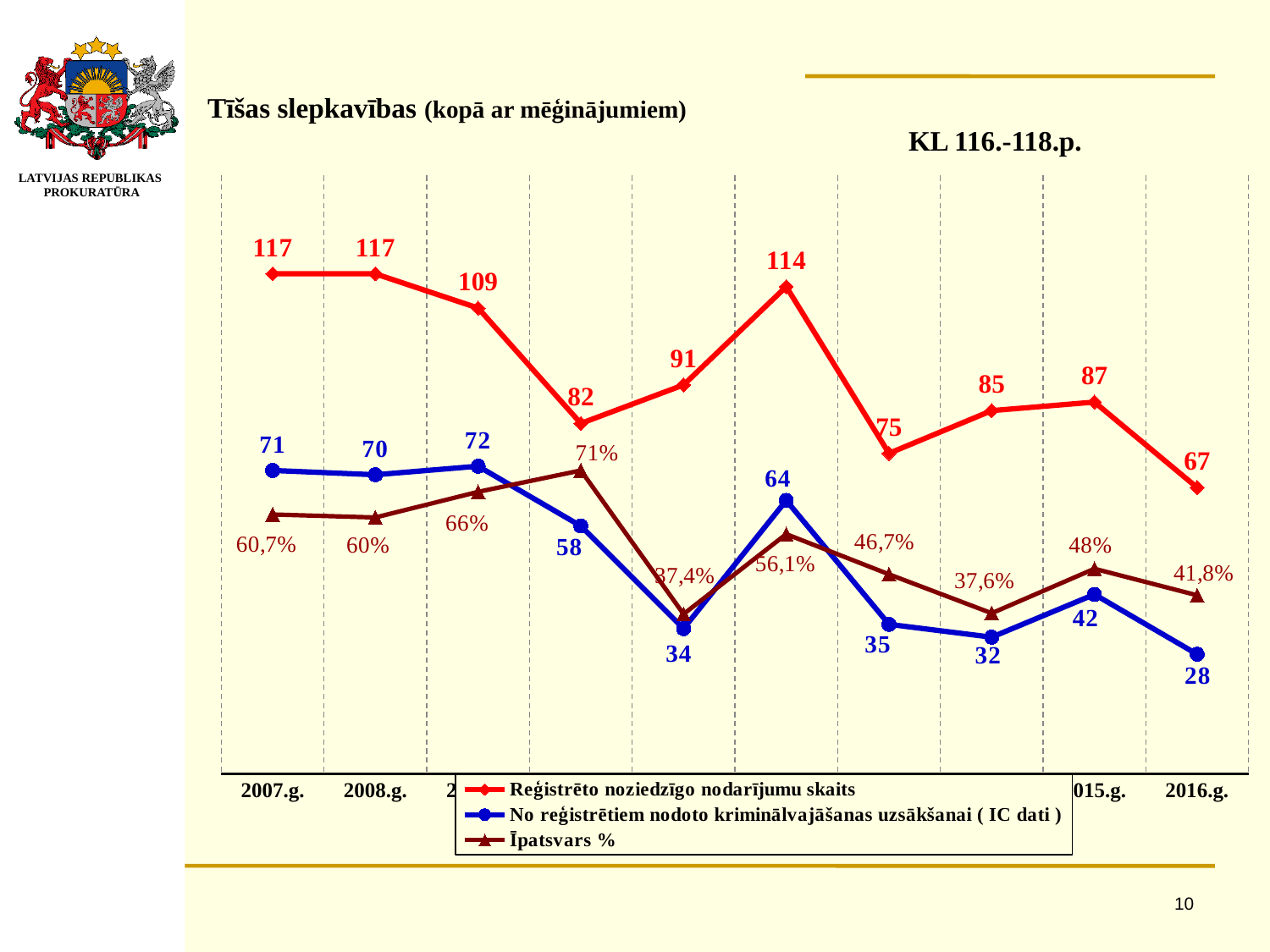
What is the Īpatsvars % value for 2007.g.? 60,7% What is the value of No reģistrētiem nodoto kriminālvajāšanas uzsākšanai (IC dati) for 2016.g.? 28 In which year is Reģistrēto noziedzīgo nodarījumu skaits lowest? 2016.g. What is the difference between No reģistrētiem nodoto kriminālvajāšanas uzsākšanai (IC dati) in 2015.g. and 2016.g.? 14 What is the Īpatsvars % value for 2015.g.? 48% What kind of chart is shown on the slide? Line chart What is the value of Reģistrēto noziedzīgo nodarījumu skaits for 2007.g.? 117 Which year has the larger Reģistrēto noziedzīgo nodarījumu skaits, 2015.g. or 2016.g.? 2015.g. What is the difference between Reģistrēto noziedzīgo nodarījumu skaits in 2007.g. and 2016.g.? 50 How many series does the legend list? 3 How many data points does each series have? 10 In which year is No reģistrētiem nodoto kriminālvajāšanas uzsākšanai (IC dati) lowest? 2016.g.